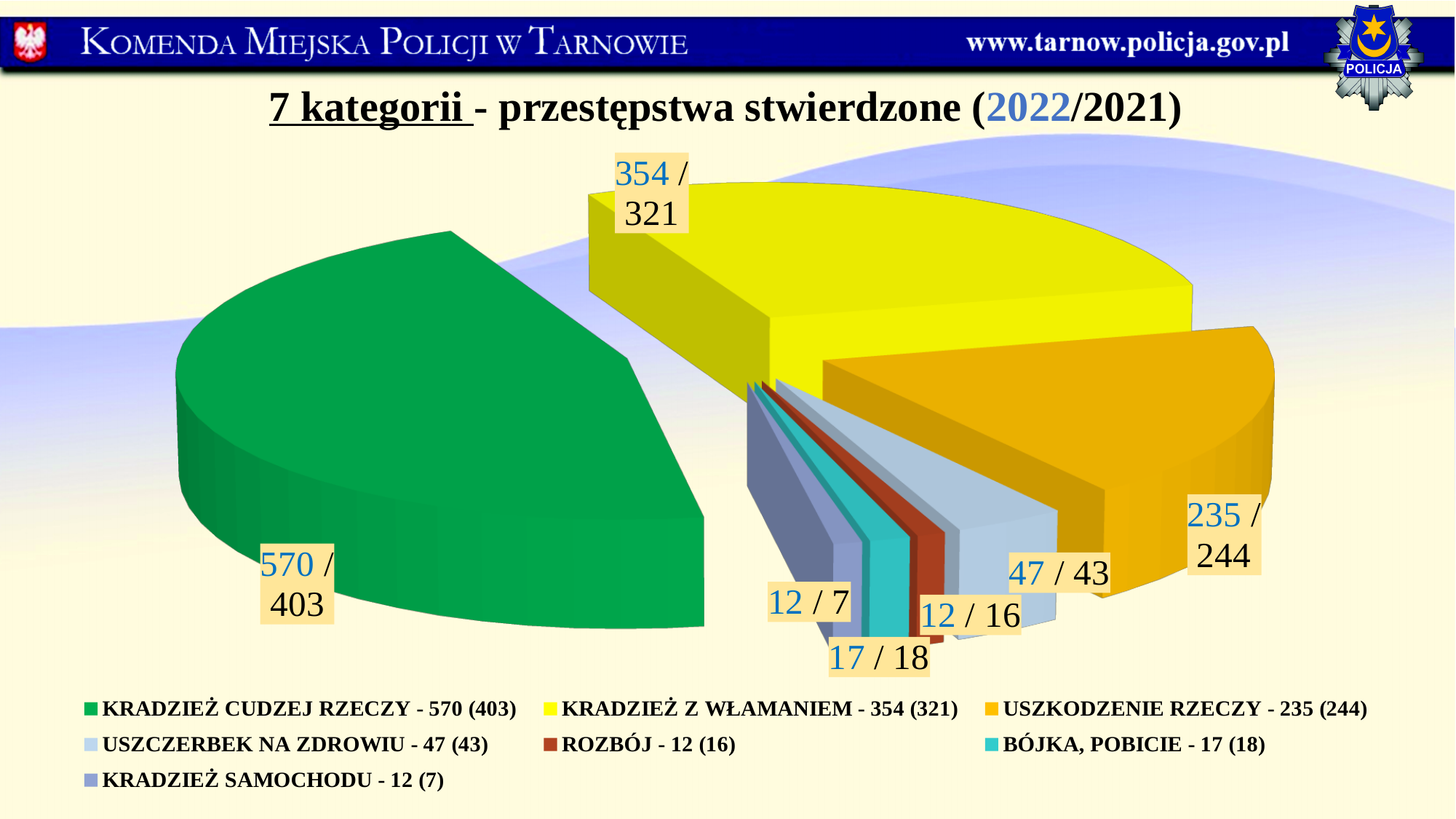
What is the 2022 value for KRADZIEŻ CUDZEJ RZECZY? 570 What is the 2022 value for USZKODZENIE RZECZY? 235 What is the difference between the 2022 values for KRADZIEŻ Z WŁAMANIEM and USZKODZENIE RZECZY? 119 What type of chart is shown on the slide? pie chart Which category has the lowest 2021 value? KRADZIEŻ SAMOCHODU Which category has the highest 2022 value? KRADZIEŻ CUDZEJ RZECZY What colour is the slice for BÓJKA, POBICIE? cyan Which is larger for USZKODZENIE RZECZY, the 2022 value or the 2021 value? 2021 value (244) What is the 2021 value for KRADZIEŻ SAMOCHODU? 7 What is the difference between the 2022 and 2021 values for KRADZIEŻ CUDZEJ RZECZY? 167 What is the 2021 value for KRADZIEŻ Z WŁAMANIEM? 321 How many categories does the pie chart show? 7